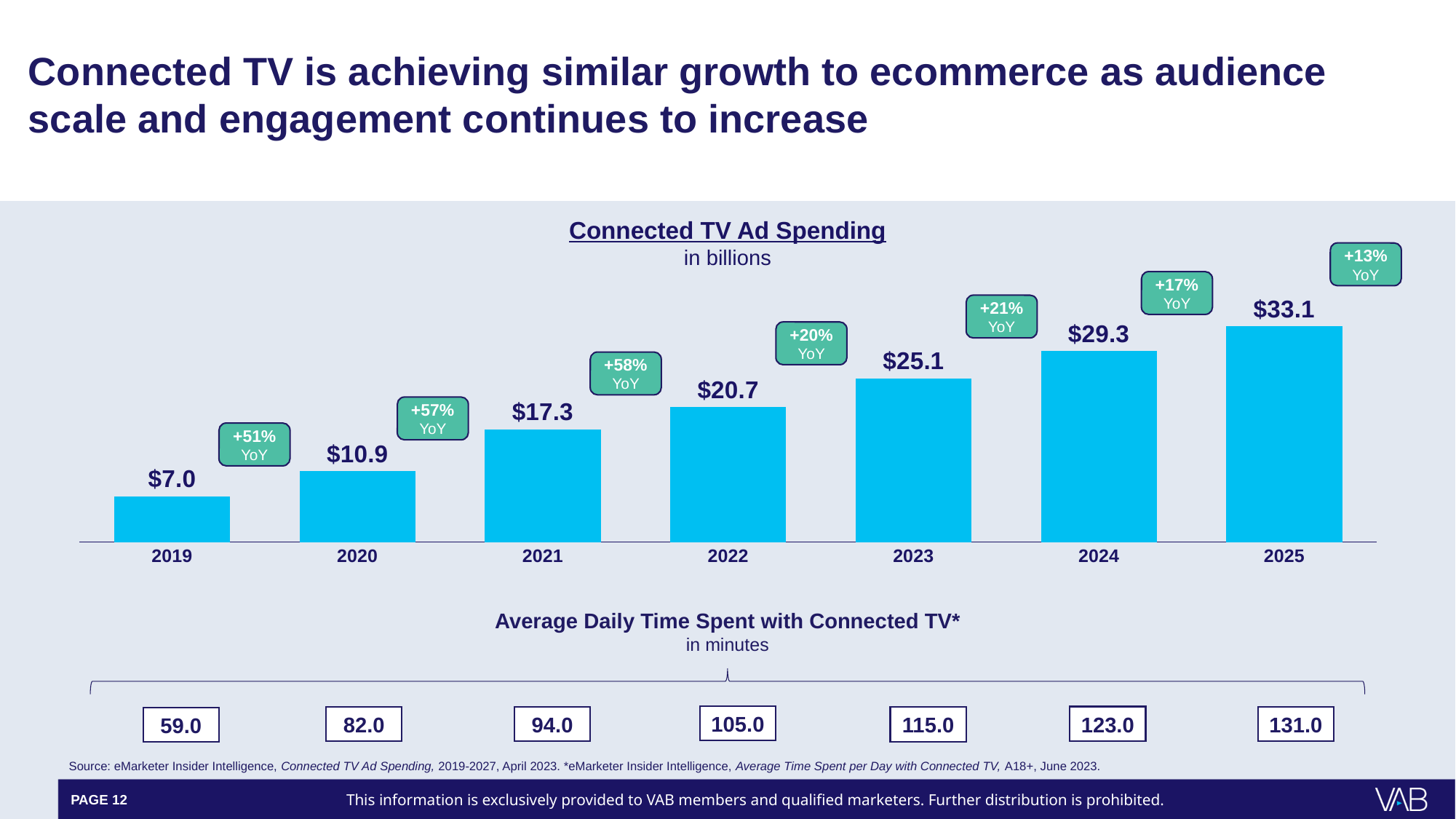
What is the average daily time spent with Connected TV in minutes for 2023? 115.0 What is the Connected TV ad spending value for 2022? $20.7 Which year has the lowest Connected TV ad spending? 2019 What kind of chart is the Connected TV Ad Spending chart? bar chart What is the difference in Connected TV ad spending between 2025 and 2024? $3.8 What unit is the Connected TV Ad Spending chart measured in, according to its subtitle? in billions Which year has higher Connected TV ad spending, 2021 or 2023? 2023 What is the Connected TV ad spending value for 2019? $7.0 Which year has the highest Connected TV ad spending? 2025 Do Connected TV ad spending values rise or fall from 2019 to 2025? rise What is the year-over-year growth percentage shown for 2021 in the Connected TV Ad Spending chart? +58% How many years are shown in the Connected TV Ad Spending chart? 7